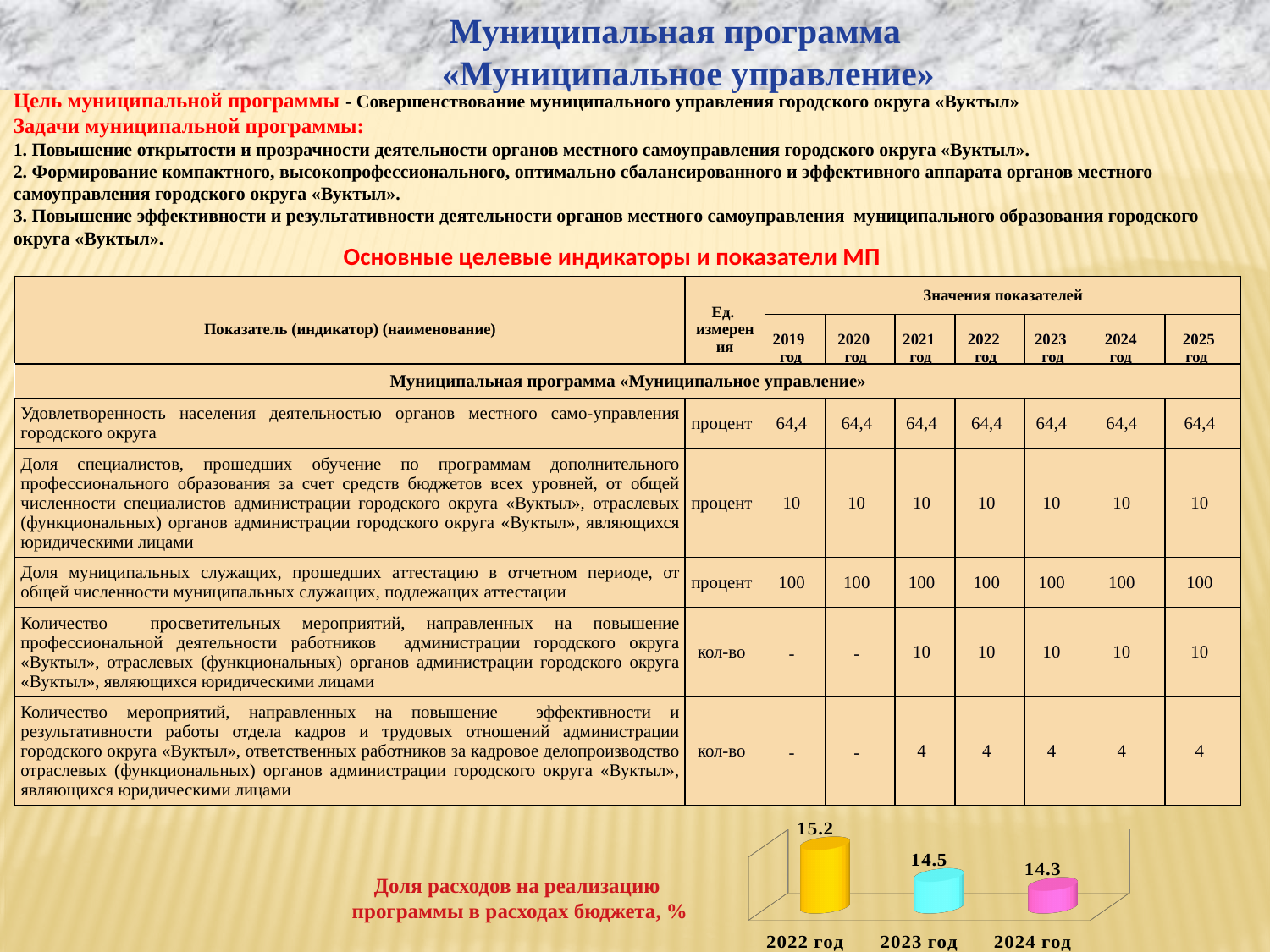
In the chart at the bottom of the slide, what is the difference between the values for 2022 год and 2023 год? 0.7 What is the value for 2024 год in the chart at the bottom of the slide? 14.3 What does the chart at the bottom of the slide show, according to the text next to it? Доля расходов на реализацию программы в расходах бюджета, % Do the values in the chart at the bottom of the slide rise or fall from 2022 год to 2024 год? fall What kind of chart is shown at the bottom of the slide? bar chart In the chart at the bottom of the slide, what is the difference between the values for 2022 год and 2024 год? 0.9 What is the value for 2022 год in the chart at the bottom of the slide? 15.2 Which year has the highest value in the chart at the bottom of the slide? 2022 год In the chart at the bottom of the slide, which is larger: the value for 2023 год or the value for 2024 год? 2023 год What is the value for 2023 год in the chart at the bottom of the slide? 14.5 How many categories (years) are shown in the chart at the bottom of the slide? 3 Which year has the lowest value in the chart at the bottom of the slide? 2024 год